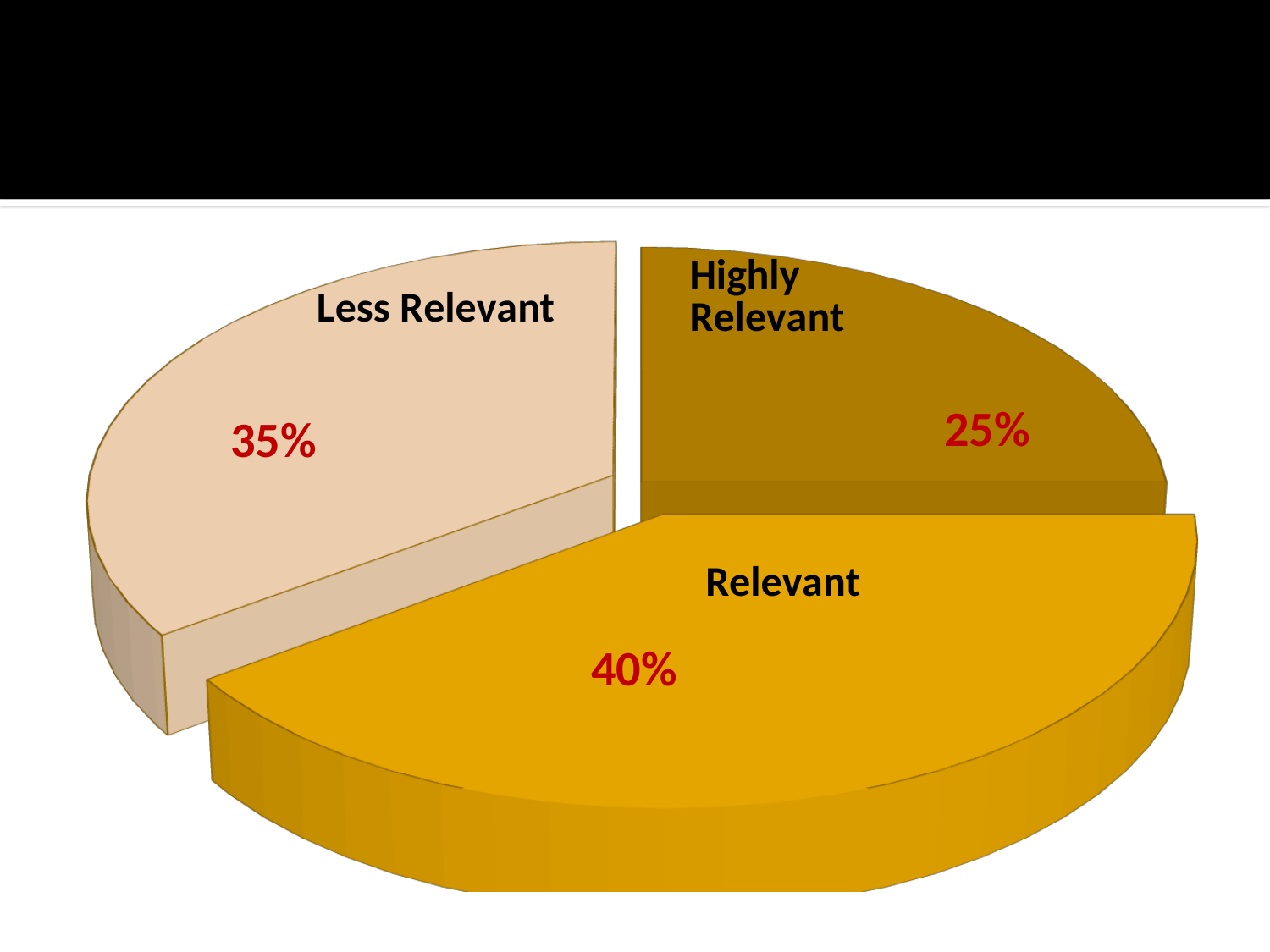
What percentage is shown for the Relevant slice? 40% What is the difference between the Less Relevant and Highly Relevant shares? 10% What percentage is shown for the Highly Relevant slice? 25% How many slices does the pie chart have? 3 What kind of chart is shown on the slide? pie chart What share of the pie does the Less Relevant slice represent? 35% What percentage is shown for the Less Relevant slice? 35% Which is larger, the Less Relevant slice or the Highly Relevant slice? Less Relevant Which slice has the largest share? Relevant What colour is the Less Relevant slice? light beige Which slice has the smallest share? Highly Relevant What is the difference between the Relevant and Highly Relevant shares? 15%